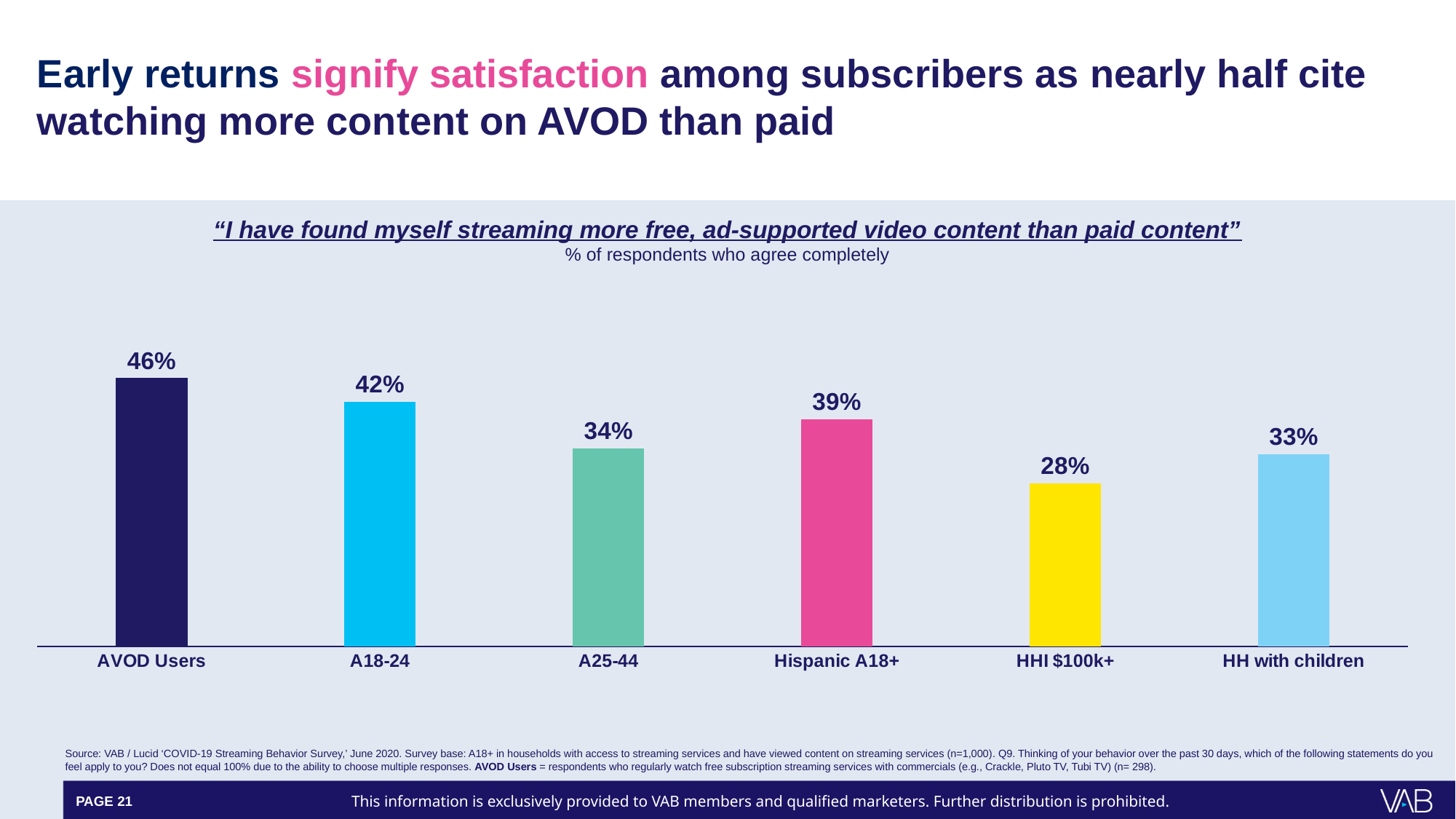
What colour is the bar for HHI $100k+? Yellow What is the difference in percentage points between A18-24 and A25-44? 8 Which is larger, the value for Hispanic A18+ or the value for HH with children? Hispanic A18+ What is the difference in percentage points between AVOD Users and HHI $100k+? 18 What is the value shown for HHI $100k+? 28% What percentage of AVOD Users agree completely that they have found themselves streaming more free, ad-supported video content than paid content? 46% Which category has the highest percentage of respondents who agree completely? AVOD Users Which category has the lowest percentage of respondents who agree completely? HHI $100k+ What kind of chart is shown on the slide? Bar chart How many categories are shown on the chart? 6 What is the value shown for Hispanic A18+? 39% What is the value shown for HH with children? 33%